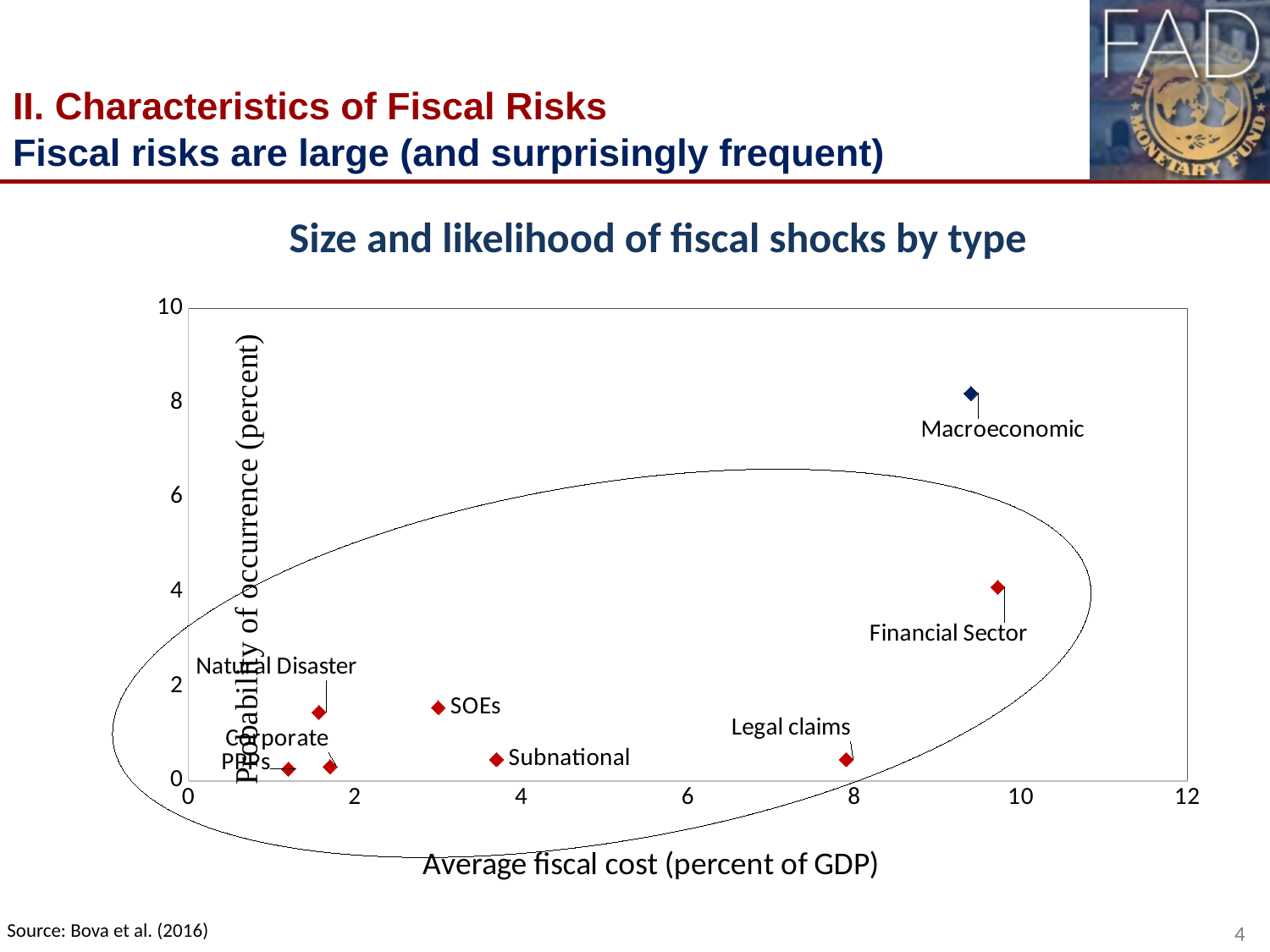
Is the probability of occurrence for Legal claims greater or less than 2? less Is the average fiscal cost for Financial Sector greater or less than 8? greater Which fiscal shock type has the highest probability of occurrence? Macroeconomic What is the label of the x axis of the chart? Average fiscal cost (percent of GDP) Which has a higher probability of occurrence, Macroeconomic or Financial Sector? Macroeconomic How many fiscal shock types are plotted as points on the chart? 8 Is the probability of occurrence for Macroeconomic greater or less than 6? greater What kind of chart is shown on the slide? Scatter chart Which has a higher average fiscal cost, Legal claims or SOEs? Legal claims What is the title of the chart? Size and likelihood of fiscal shocks by type Which fiscal shock type has the lowest average fiscal cost? PPPs Which has a higher probability of occurrence, Natural Disaster or Subnational? Natural Disaster